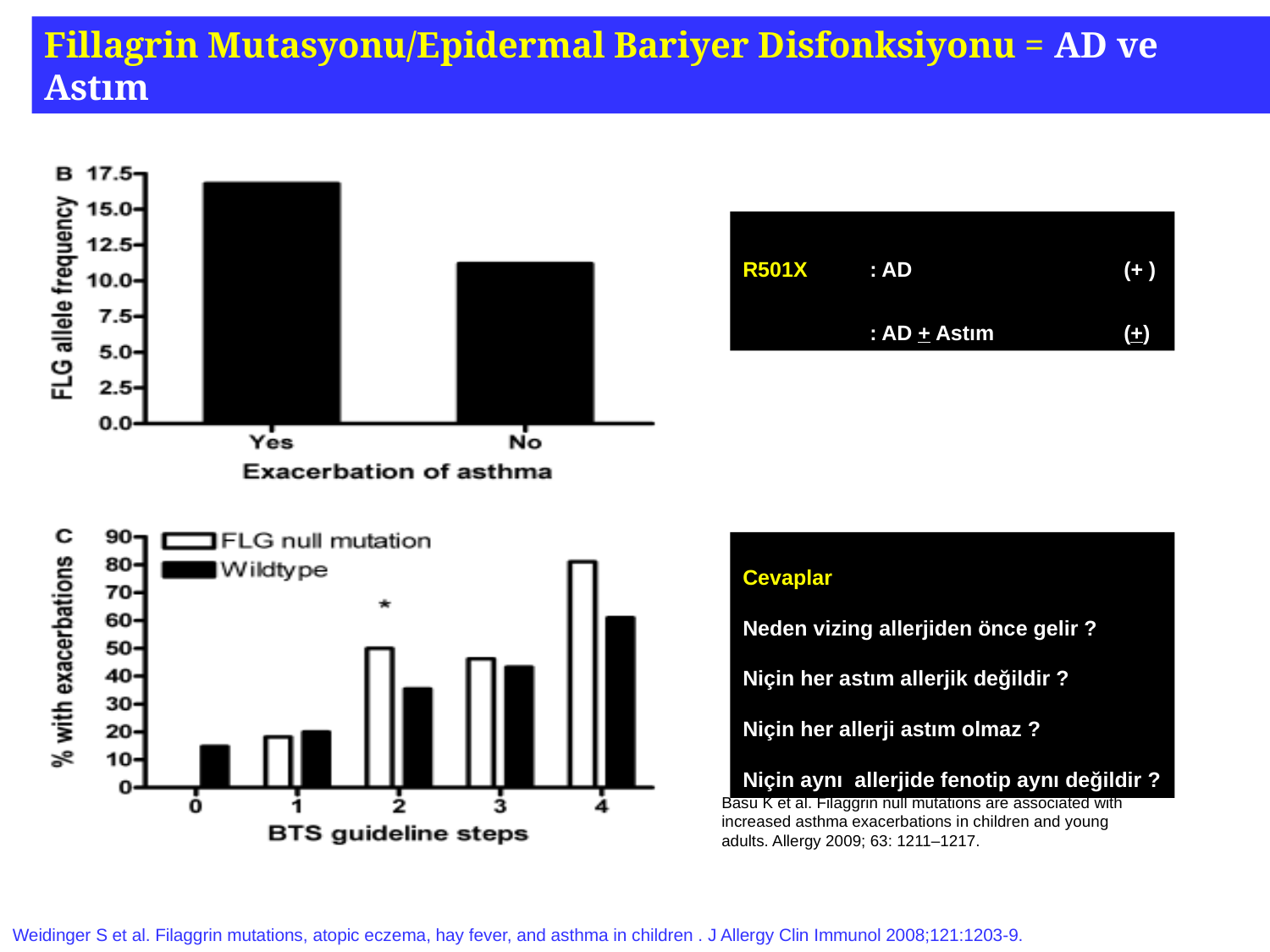
In the bottom chart (% with exacerbations), at which BTS guideline step is the FLG null mutation value highest? 4 In the top chart (FLG allele frequency), which category has the higher FLG allele frequency, Yes or No? Yes In the bottom chart (% with exacerbations), is the Wildtype value at step 2 greater or less than 40? less In the top chart (FLG allele frequency), is the value for Yes greater or less than 15? greater In the bottom chart (% with exacerbations), at BTS guideline step 4, which series has the higher value? FLG null mutation What are the two legend entries in the bottom chart (% with exacerbations)? FLG null mutation and Wildtype In the bottom chart (% with exacerbations), is the FLG null mutation value at step 4 greater or less than 70? greater What is the x-axis title of the bottom chart (% with exacerbations)? BTS guideline steps How many categories are shown on the x axis of the top chart (Exacerbation of asthma)? 2 What kind of chart is the top chart (FLG allele frequency vs Exacerbation of asthma)? bar chart How many series does the legend of the bottom chart (% with exacerbations) list? 2